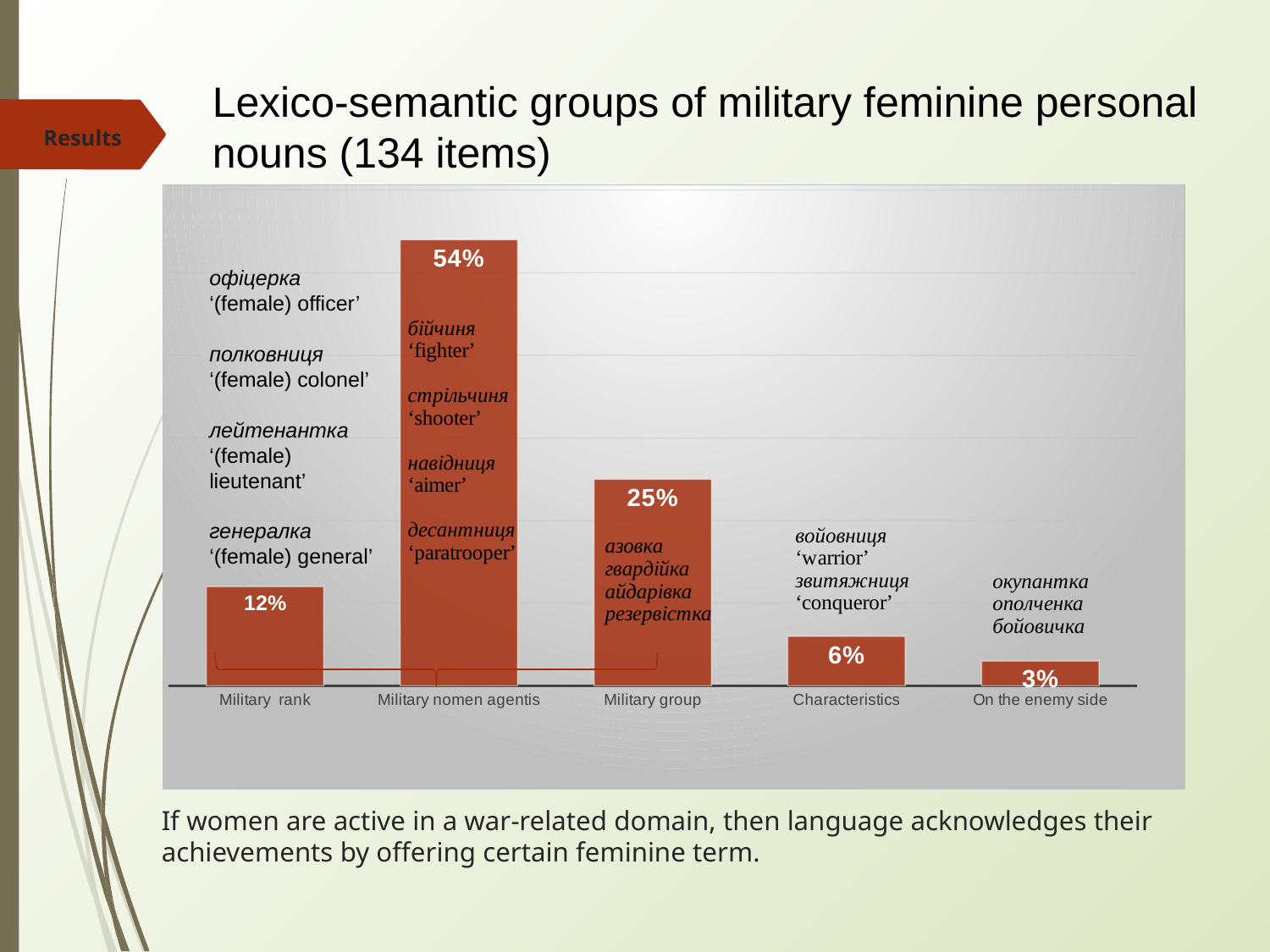
What is the value for On the enemy side? 3% What is the value for Military rank? 12% Which category has the lowest value? On the enemy side What is the value for Characteristics? 6% Which is larger, the value for Military rank or the value for Characteristics? Military rank What kind of chart is shown on the slide? Bar chart What is the title of the slide containing the chart? Lexico-semantic groups of military feminine personal nouns (134 items) What is the value for Military group? 25% Which category has the highest value? Military nomen agentis How many categories are shown on the x axis? 5 What is the difference between the values for Military nomen agentis and Military group? 29% What is the value for Military nomen agentis? 54%